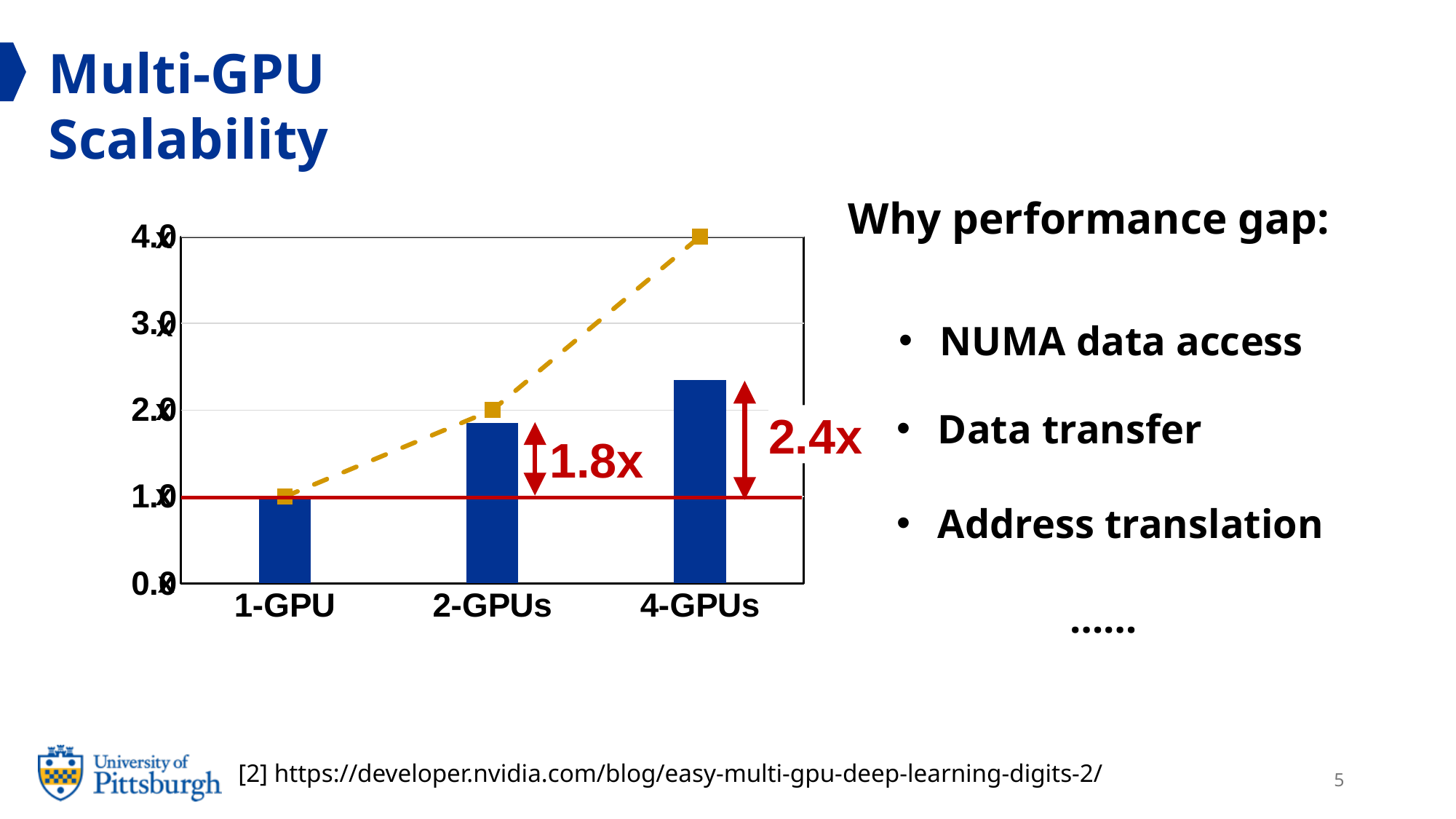
Which category has the tallest bar? 4-GPUs How many categories are shown on the x axis of the chart? 3 Which bar is taller, 2-GPUs or 4-GPUs? 4-GPUs What kind of chart is shown on the slide? combination bar and line chart At what y-axis value is the horizontal red line drawn? 1.0 Do the bars rise or fall from 1-GPU to 4-GPUs? rise Is the bar for 2-GPUs greater or less than 2.0? less What speedup is annotated next to the 4-GPUs bar? 2.4x What value does the dashed line reach at 4-GPUs? 4.0 Which category has the shortest bar? 1-GPU Is the bar for 4-GPUs greater or less than 3.0? less What speedup is annotated next to the 2-GPUs bar? 1.8x